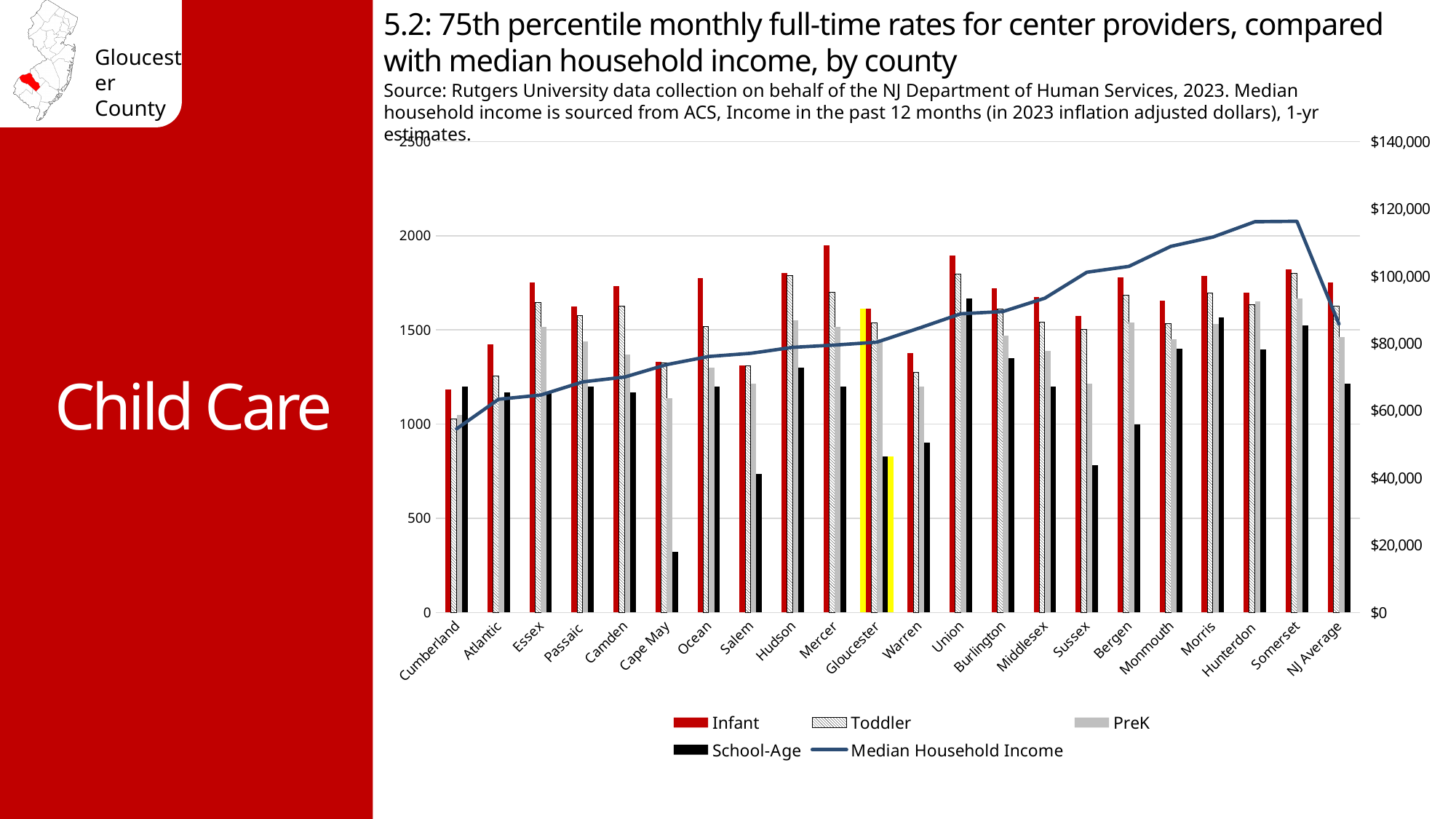
Which is larger, the Infant rate for Mercer or for Cumberland? Mercer Is the Infant rate for Cumberland greater or less than 1500? less Does the Median Household Income line generally rise or fall from Cumberland to Somerset? rise Which category has the highest Infant rate? Mercer Is the School-Age rate for Cape May greater or less than 500? less How many categories are shown along the x axis? 22 Is the Median Household Income for Somerset greater or less than $100,000? greater Which category has the lowest School-Age rate? Cape May Which category has the lowest Infant rate? Cumberland What kind of chart is shown on the slide? Bar chart with a line Which county's bars are highlighted in yellow? Gloucester How many series does the legend list? 5